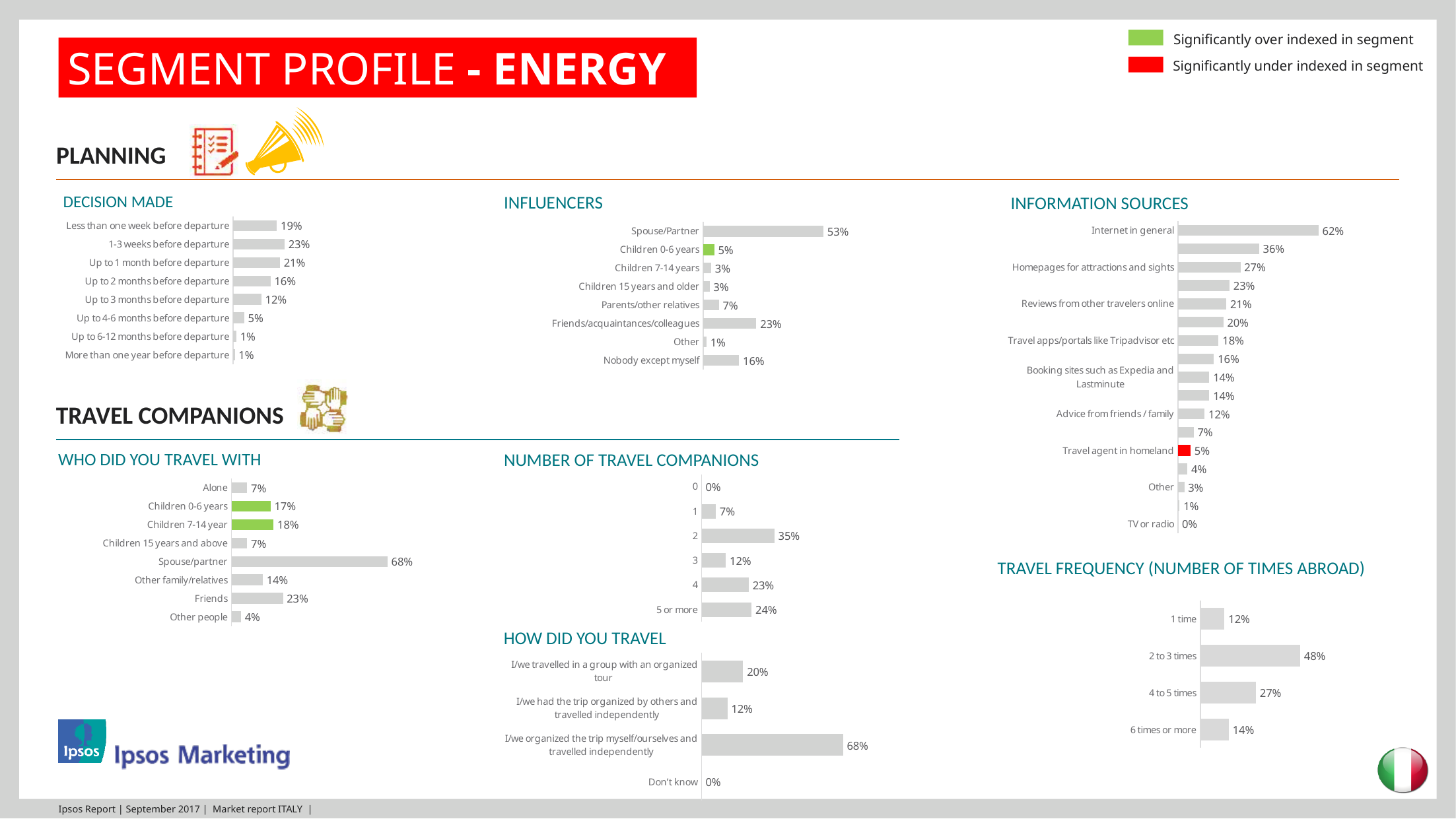
In the WHO DID YOU TRAVEL WITH chart, which category has the highest value? Spouse/partner In the INFORMATION SOURCES chart, what is the value for 'Internet in general'? 62% In the DECISION MADE chart, which category has the highest value? 1-3 weeks before departure In the INFLUENCERS chart, what is the difference between Friends/acquaintances/colleagues and Nobody except myself? 7 percentage points In the NUMBER OF TRAVEL COMPANIONS chart, what is the value for 2 companions? 35% In the HOW DID YOU TRAVEL chart, what is the value for 'I/we organized the trip myself/ourselves and travelled independently'? 68% What kind of chart is the TRAVEL FREQUENCY (NUMBER OF TIMES ABROAD) chart? Bar chart How many categories are shown in the WHO DID YOU TRAVEL WITH chart? 8 In the INFORMATION SOURCES chart, which is larger: 'Reviews from other travelers online' or 'Travel apps/portals like Tripadvisor etc'? Reviews from other travelers online In the DECISION MADE chart, what is the value for '1-3 weeks before departure'? 23% In the NUMBER OF TRAVEL COMPANIONS chart, which category has the lowest value? 0 In the INFLUENCERS chart, what is the value for Spouse/Partner? 53%